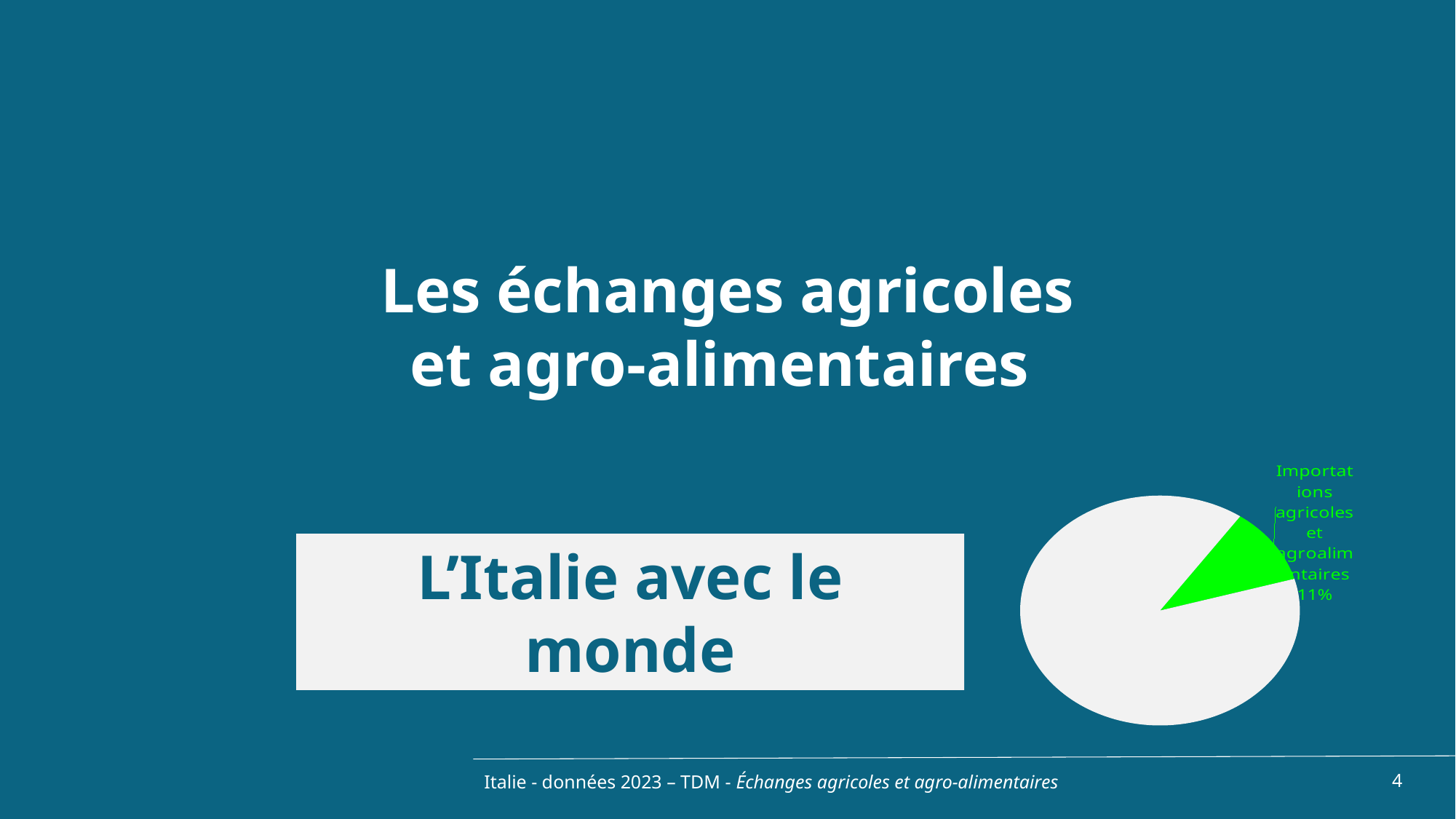
Is the share of the green slice greater or less than 50%? less What kind of chart is shown on the slide? pie chart How many slices does the pie chart have? 2 What share of the pie does the slice labelled "Importations agricoles et agroalimentaires" represent? 11% Which slice of the pie is larger, the green labelled slice or the white unlabelled slice? the white unlabelled slice What colour is the slice labelled "Importations agricoles et agroalimentaires"? green What is the label of the green slice in the pie chart? Importations agricoles et agroalimentaires